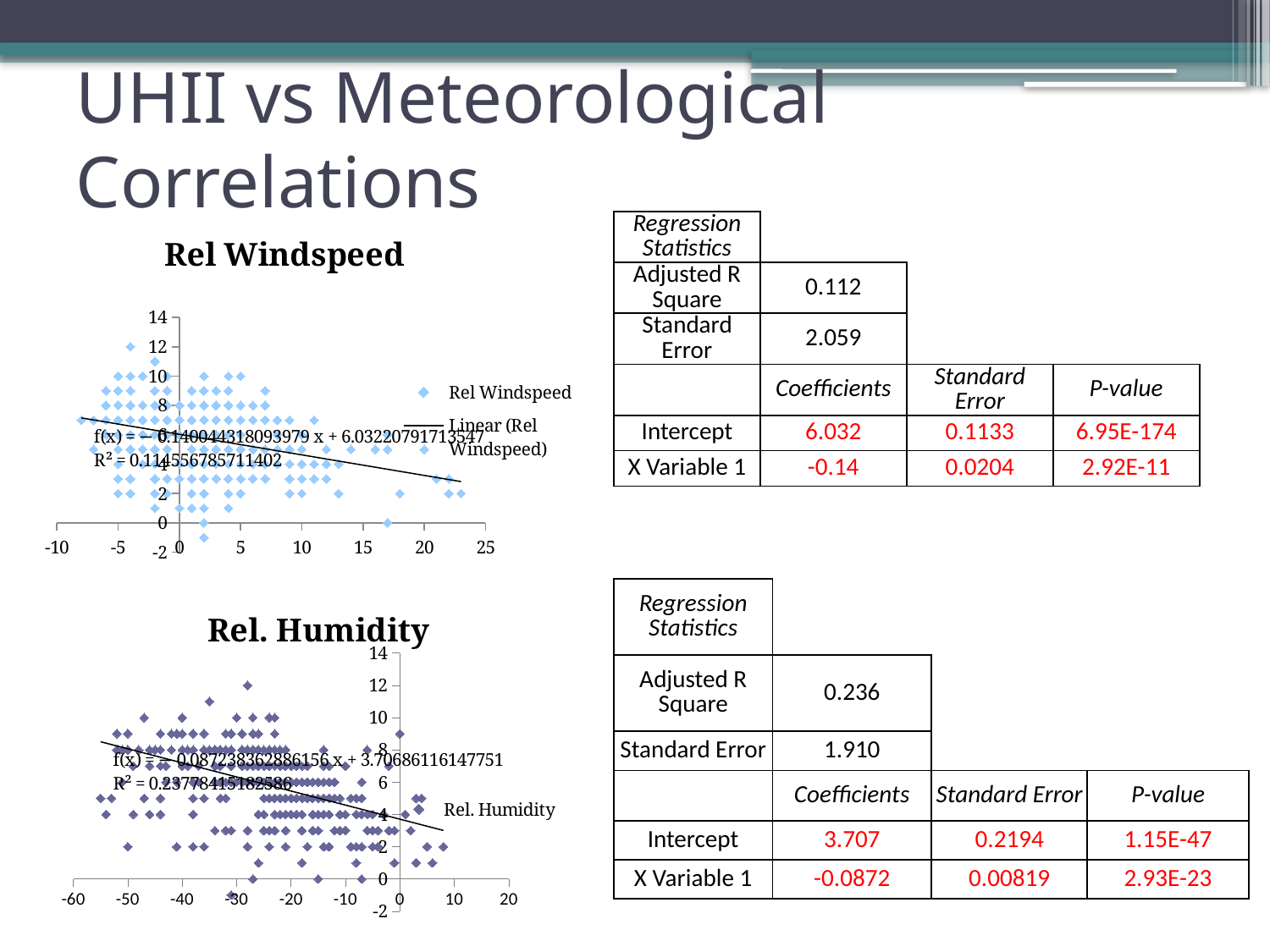
What is the slope of the trendline equation printed on the "Rel Windspeed" chart? −0.140044318093979 What is the highest tick value shown on the y axis of the "Rel Windspeed" chart? 14 What is the intercept of the trendline equation printed on the "Rel. Humidity" chart? 3.70686116147751 What kind of chart is the "Rel Windspeed" chart? scatter chart In the "Rel. Humidity" chart, does the fitted trendline rise or fall as x increases? fall What is the lowest tick value shown on the x axis of the "Rel. Humidity" chart? -60 What is the slope of the trendline equation printed on the "Rel. Humidity" chart? −0.0872383628861156 How many entries does the legend of the "Rel. Humidity" chart list? 1 In the "Rel Windspeed" chart, does the fitted trendline rise or fall as x increases? fall What R² value is printed on the "Rel Windspeed" chart? 0.114556785711402 What kind of chart is the "Rel. Humidity" chart? scatter chart How many entries does the legend of the "Rel Windspeed" chart list? 2